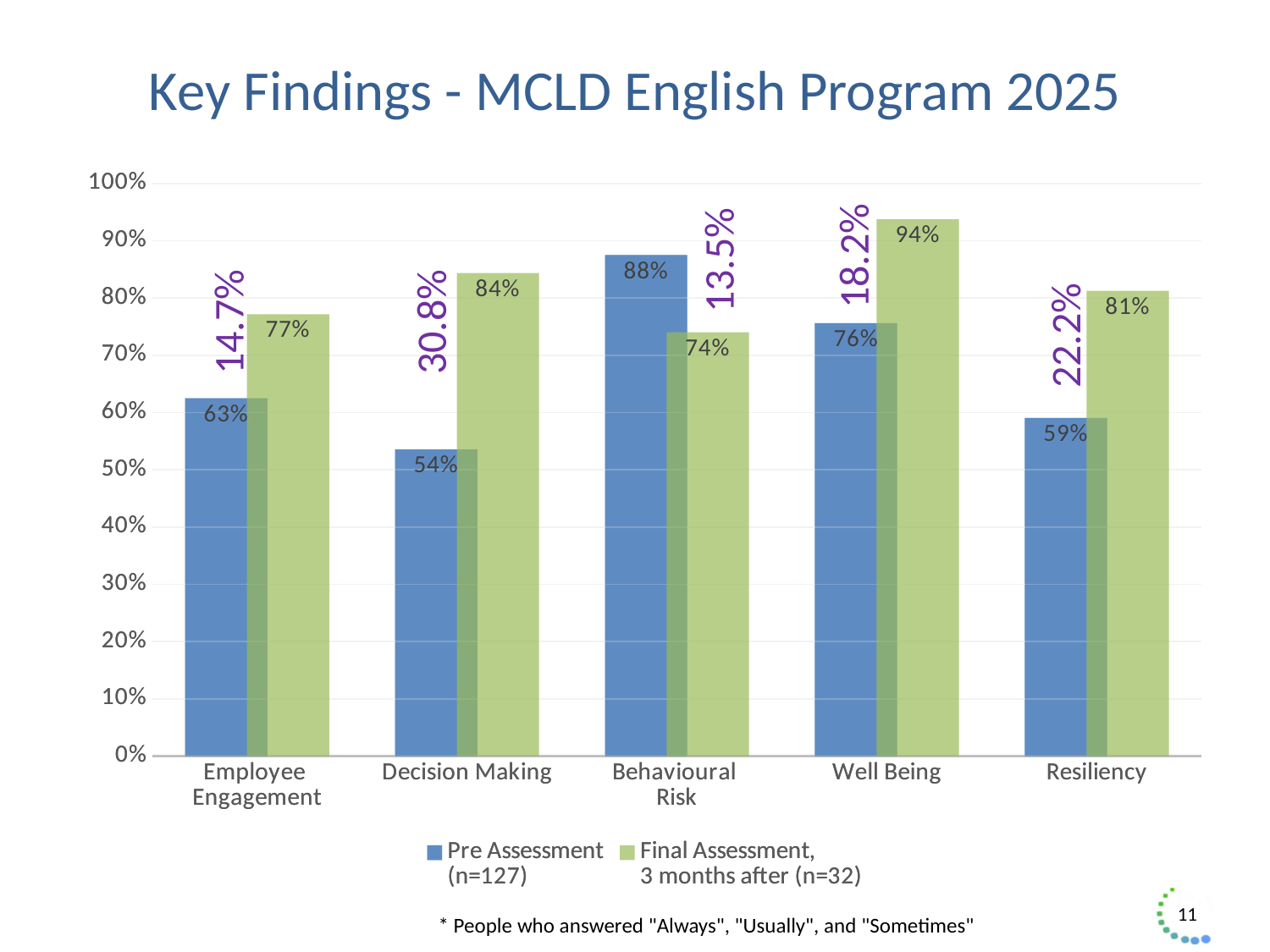
What is the purple percentage annotation shown above the Well Being bars? 18.2% Which category has the highest Final Assessment value? Well Being Is the Final Assessment value for Resiliency greater or less than 80%? greater How many series does the legend list? 2 Which category has the lowest Pre Assessment value? Decision Making How many categories are shown on the x axis? 5 What is the difference between the Final Assessment and Pre Assessment values for Decision Making? 30% What kind of chart is shown on the slide? Bar chart What is the Pre Assessment value for Decision Making? 54% For Behavioural Risk, which is larger: the Pre Assessment value or the Final Assessment value? Pre Assessment What is the Pre Assessment value for Behavioural Risk? 88% What is the Final Assessment value for Well Being? 94%